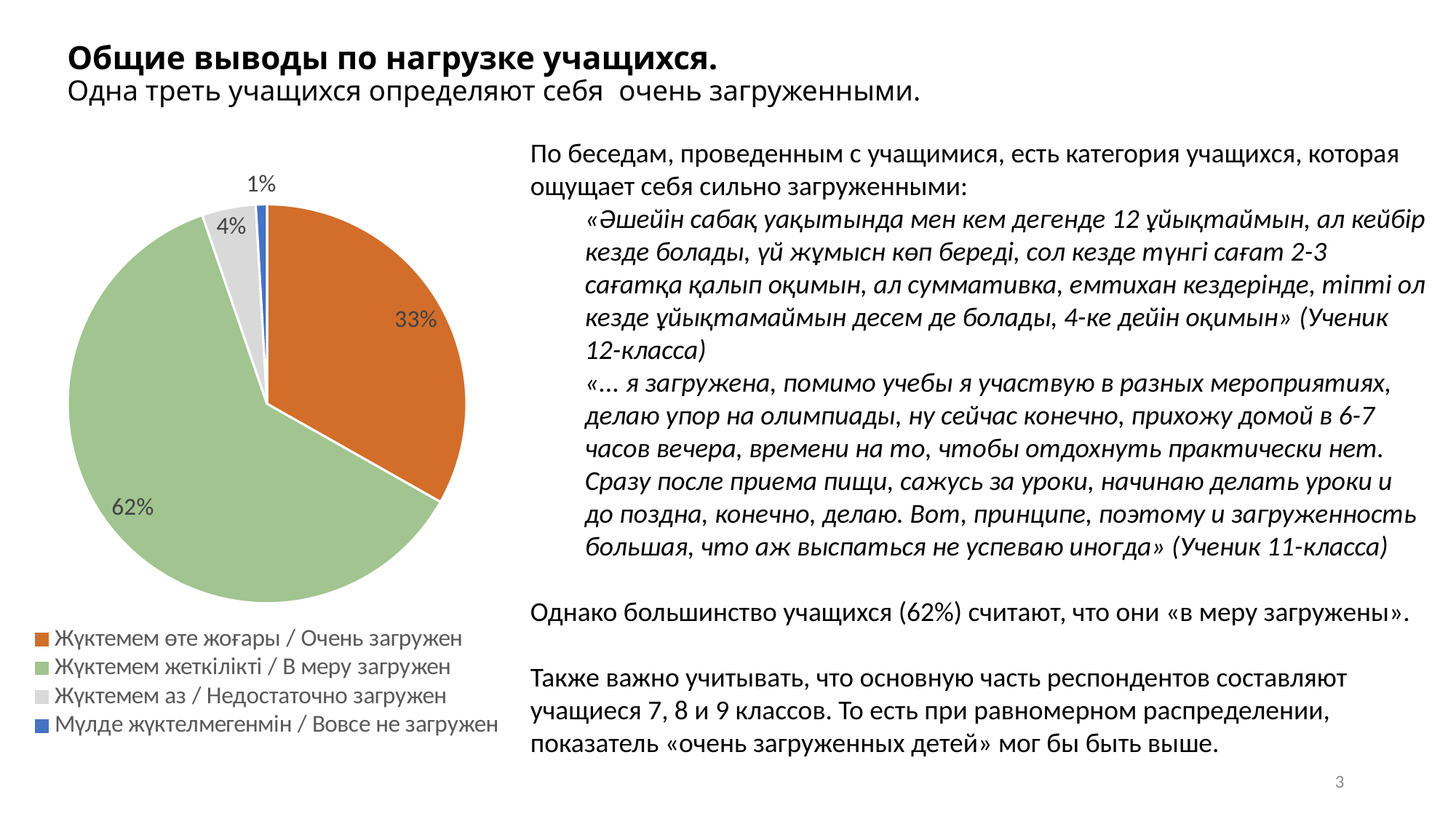
How many categories does the pie chart have? 4 Which slice is larger: "Очень загружен" or "Недостаточно загружен"? Очень загружен What is the difference in percentage points between the "В меру загружен" slice and the "Очень загружен" slice? 29 Which category has the largest slice of the pie? Жүктемем жеткілікті / В меру загружен What share of the pie is labelled "Жүктемем жеткілікті / В меру загружен"? 62% What share of the pie is labelled "Жүктемем аз / Недостаточно загружен"? 4% What colour is the slice for "Мүлде жүктелмегенмін / Вовсе не загружен"? blue What colour is the slice for "Жүктемем өте жоғары / Очень загружен"? orange What kind of chart is shown on the slide? pie chart What share of the pie is labelled "Мүлде жүктелмегенмін / Вовсе не загружен"? 1% Which category has the smallest slice of the pie? Мүлде жүктелмегенмін / Вовсе не загружен